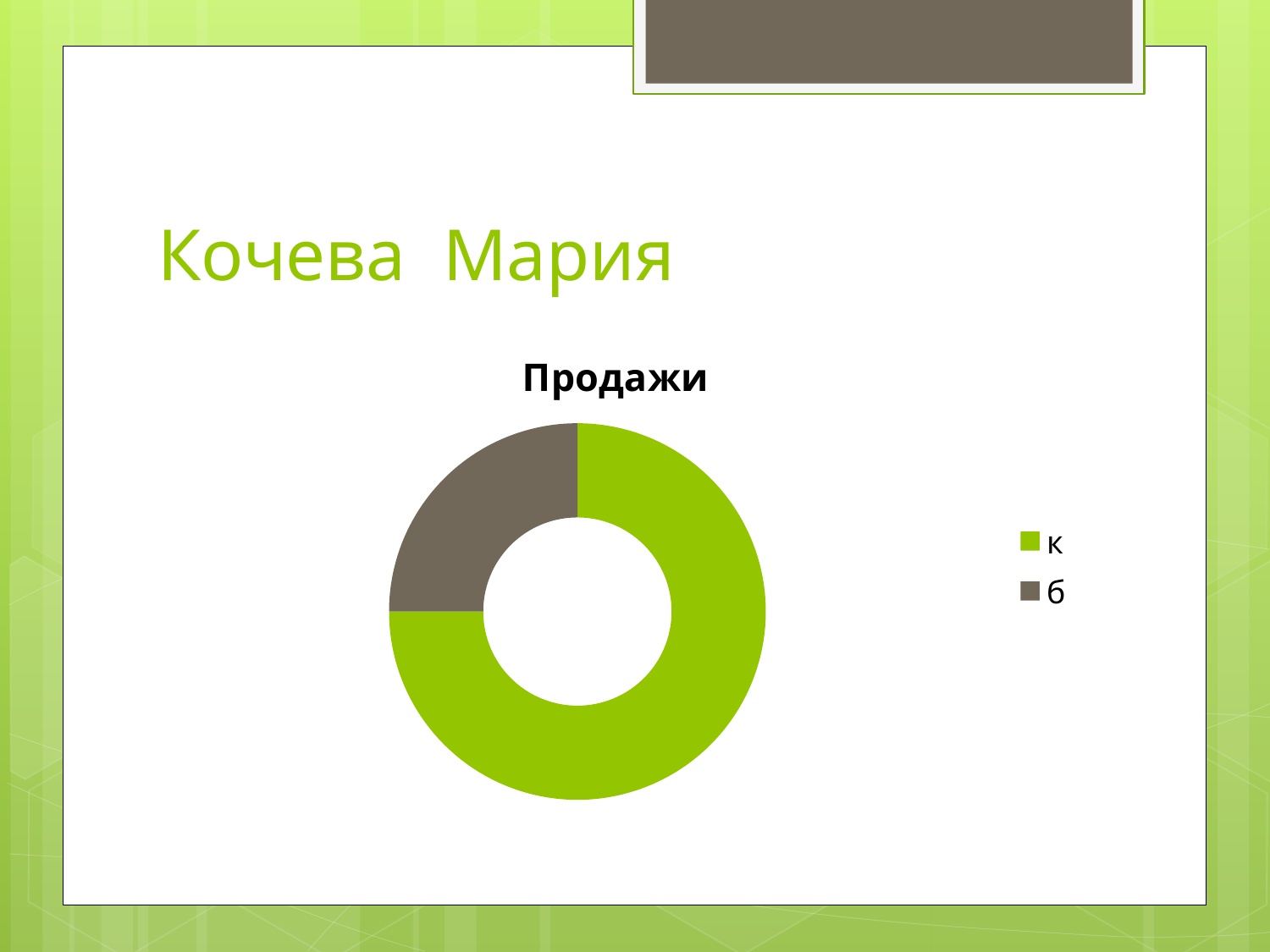
How many entries does the legend list? 2 How many categories does the chart show? 2 Which category has the smallest share of the chart? б What colour represents the category б in the chart? grey Which category has the largest share of the chart? к Which is larger, the share for к or the share for б? к What kind of chart is shown on the slide? doughnut chart What is the title of the chart? Продажи